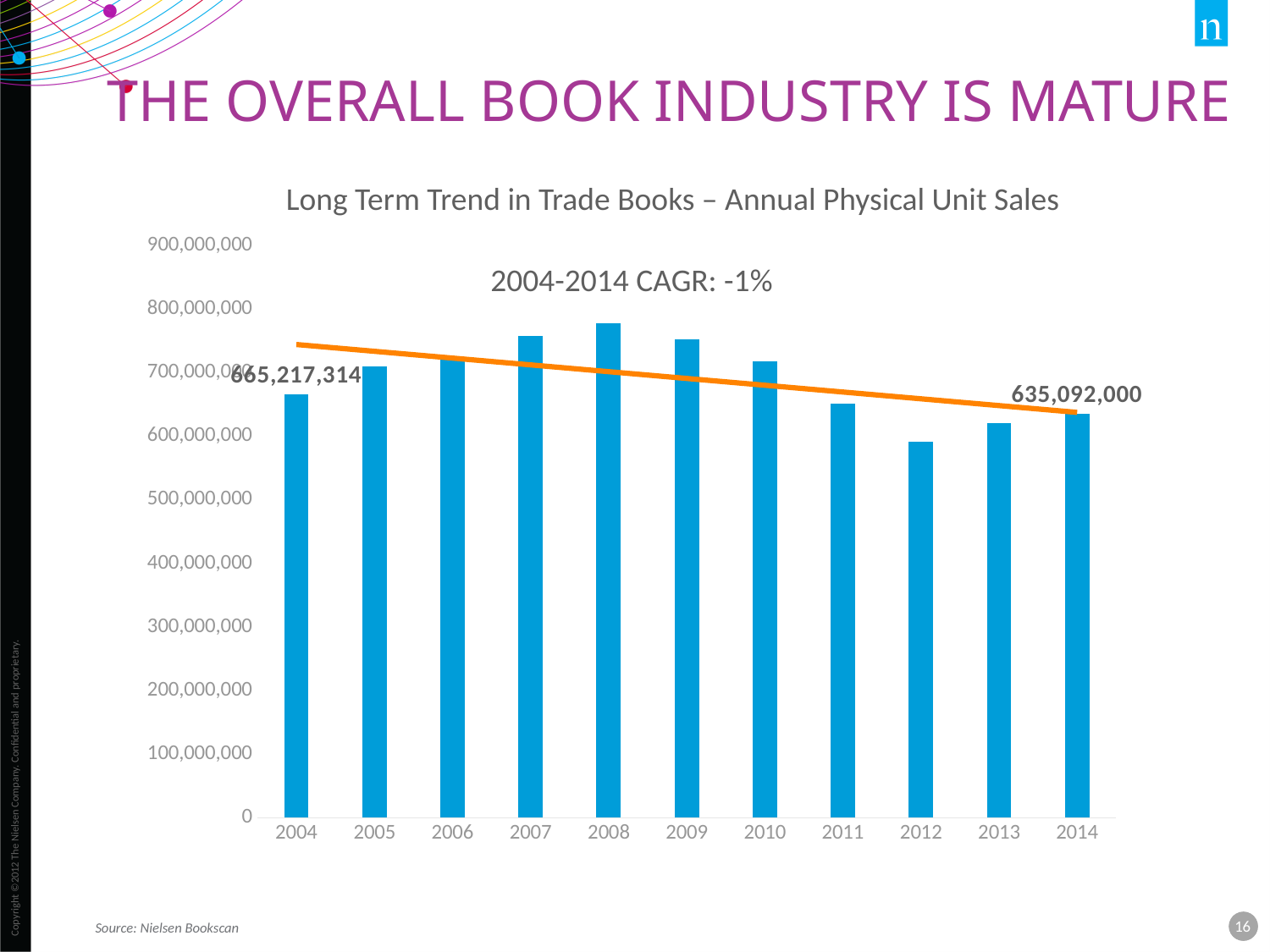
Is the value for 2012 greater or less than 600,000,000? less What is the difference between the 2004 value and the 2014 value? 30,125,314 What kind of chart is this? bar chart What is the value for 2004? 665,217,314 Which year has the lowest bar? 2012 What CAGR for 2004-2014 is stated on the chart? -1% Is the value for 2008 greater or less than 700,000,000? greater What is the value for 2014? 635,092,000 Which year has the highest bar? 2008 Is the value for 2011 greater or less than 700,000,000? less Which is larger, the value for 2004 or the value for 2014? 2004 How many years are shown on the x axis? 11